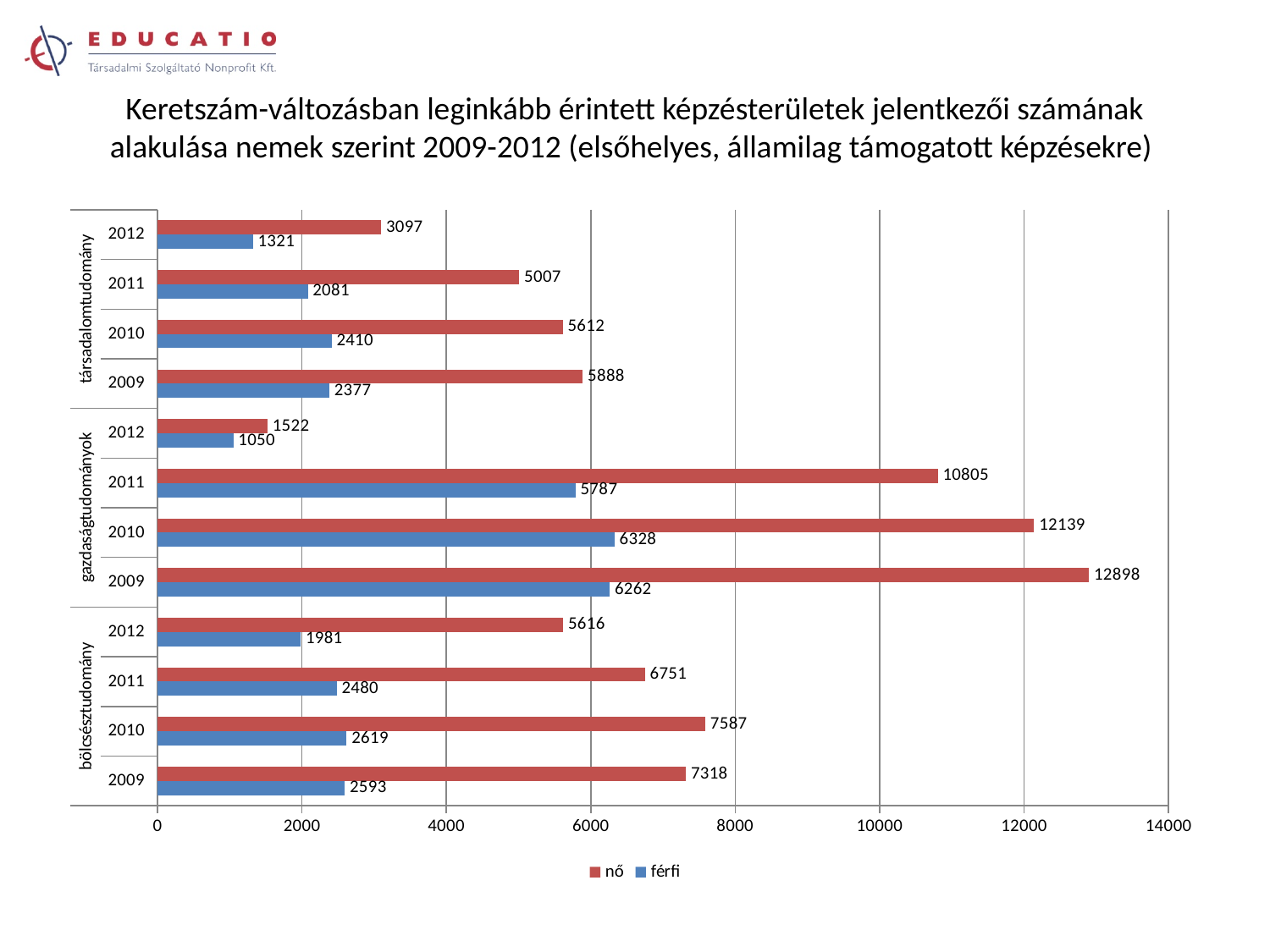
How many series does the legend list? 2 Is the nő value for gazdaságtudományok in 2011 greater or less than 10000? greater What is the difference between the nő and férfi values for gazdaságtudományok in 2010? 5811 Which colour represents the férfi series? blue Which is larger: the nő value for bölcsésztudomány in 2010 or in 2009? 2010 Which category has the lowest férfi value? gazdaságtudományok 2012 What is the value for férfi in bölcsésztudomány in 2011? 2480 How does the nő value for társadalomtudomány change from 2009 to 2012? It falls What kind of chart is shown on the slide? bar chart Which category has the highest nő value? gazdaságtudományok 2009 What is the value for nő in gazdaságtudományok in 2009? 12898 What is the value for nő in társadalomtudomány in 2012? 3097